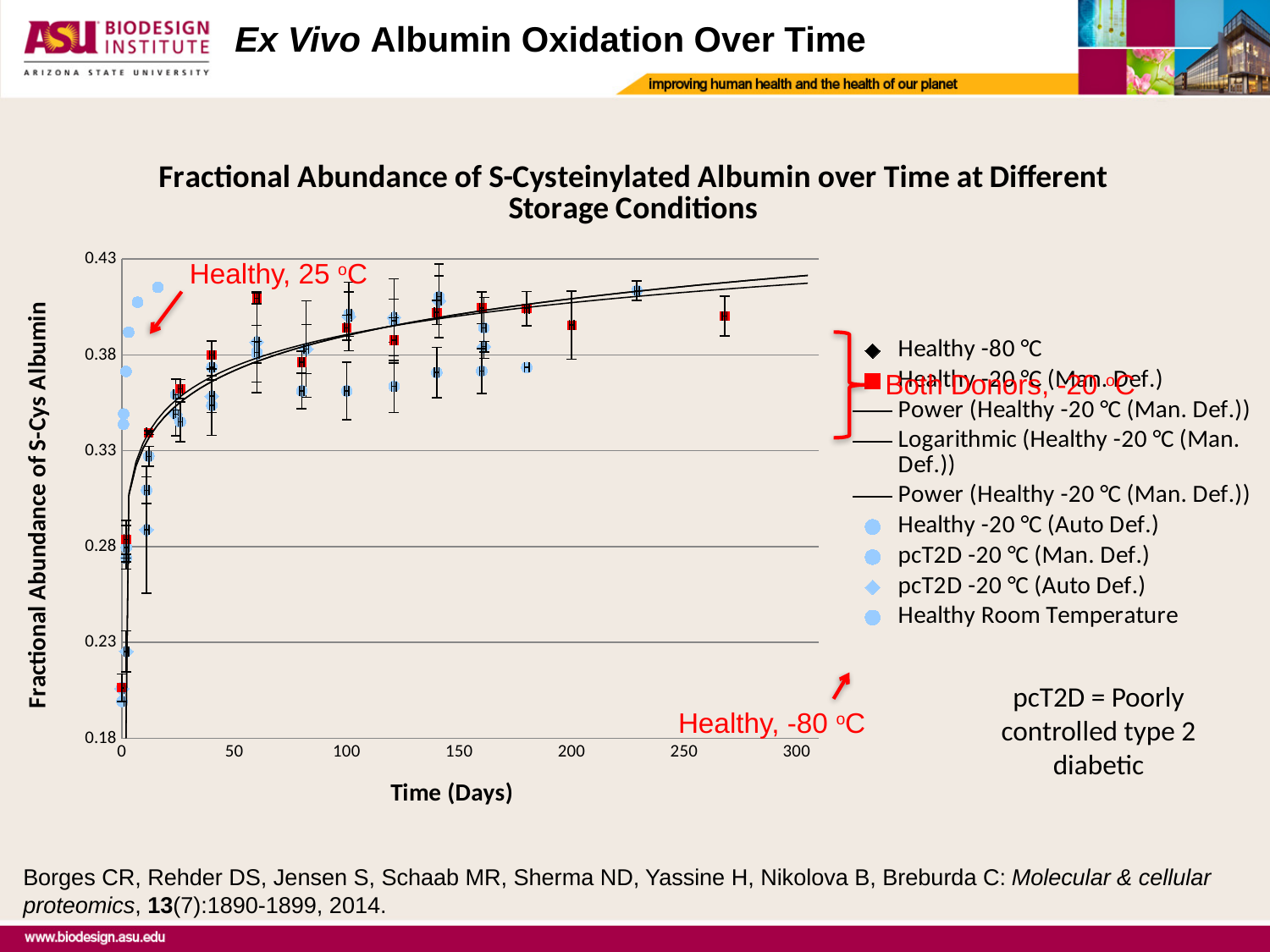
What is the lowest value shown on the y axis? 0.18 What is the highest value shown on the y axis? 0.43 What is the largest tick value shown on the x axis? 300 Do the plotted values generally rise or fall as time increases along the x axis? Rise What kind of chart is shown on the slide? Scatter chart What is the label of the x axis? Time (Days) What is the title of the chart? Fractional Abundance of S-Cysteinylated Albumin over Time at Different Storage Conditions What is the spacing between consecutive tick marks on the x axis? 50 According to the slide, what does pcT2D stand for? Poorly controlled type 2 diabetic How many entries does the chart legend list? 9 Is the Healthy -20 °C (Man. Def.) value at day 0 greater or less than 0.23? less Is the Healthy -20 °C (Man. Def.) value at about day 200 greater or less than 0.33? greater